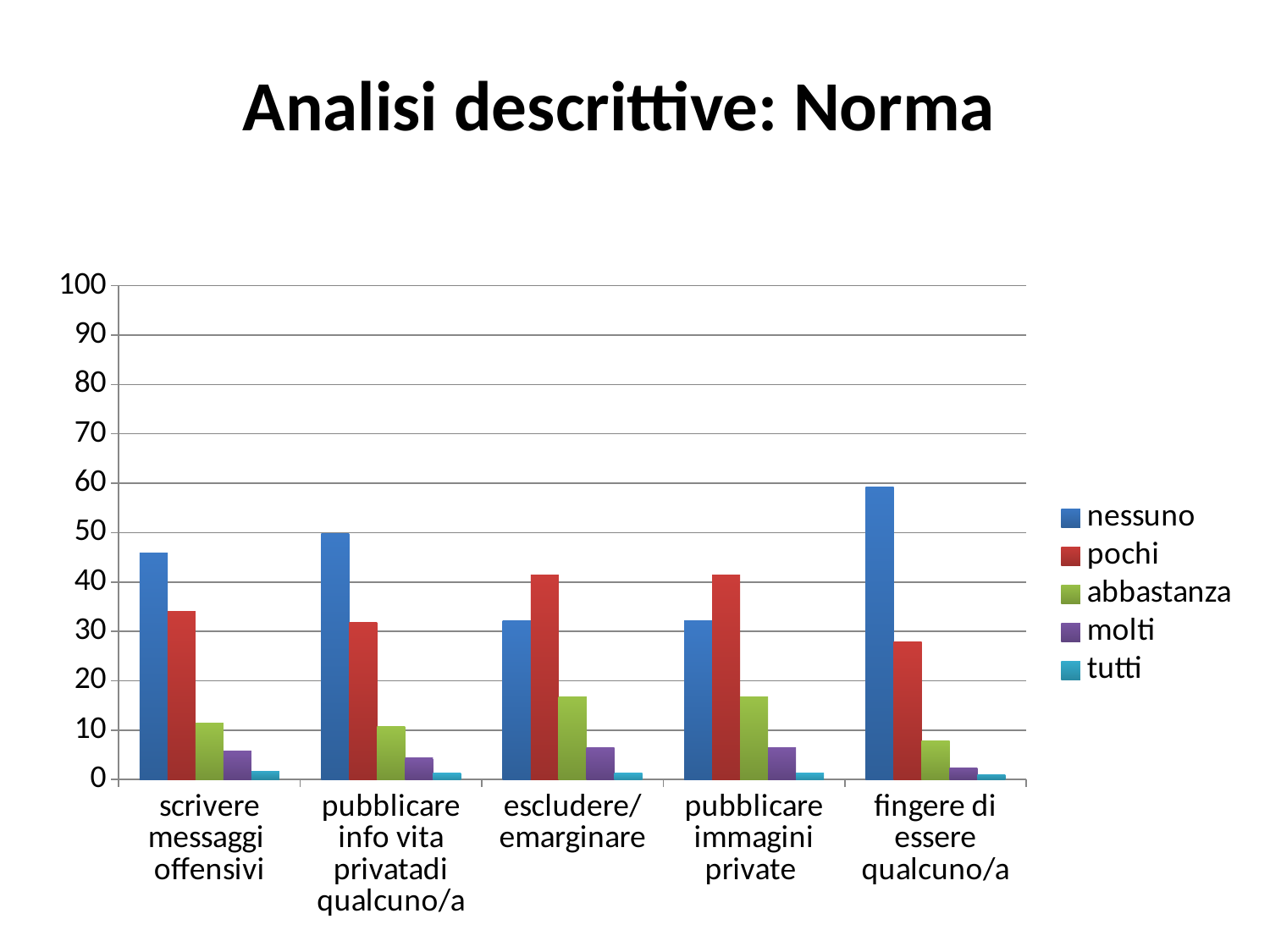
Is the 'nessuno' value for 'pubblicare info vita privata di qualcuno/a' greater or less than 40? greater Which category has the lowest value for the 'pochi' series? fingere di essere qualcuno/a Is the 'nessuno' value for 'fingere di essere qualcuno/a' greater or less than 50? greater Which category has the highest value for the 'nessuno' series? fingere di essere qualcuno/a What is the title of the slide? Analisi descrittive: Norma For 'scrivere messaggi offensivi', which is larger: the 'nessuno' value or the 'pochi' value? nessuno Is the 'abbastanza' value for 'escludere/emarginare' greater or less than 20? less How many categories are shown on the x axis? 5 What kind of chart is shown on the slide? bar chart How many series does the legend list? 5 For 'escludere/emarginare', which is larger: the 'nessuno' value or the 'pochi' value? pochi